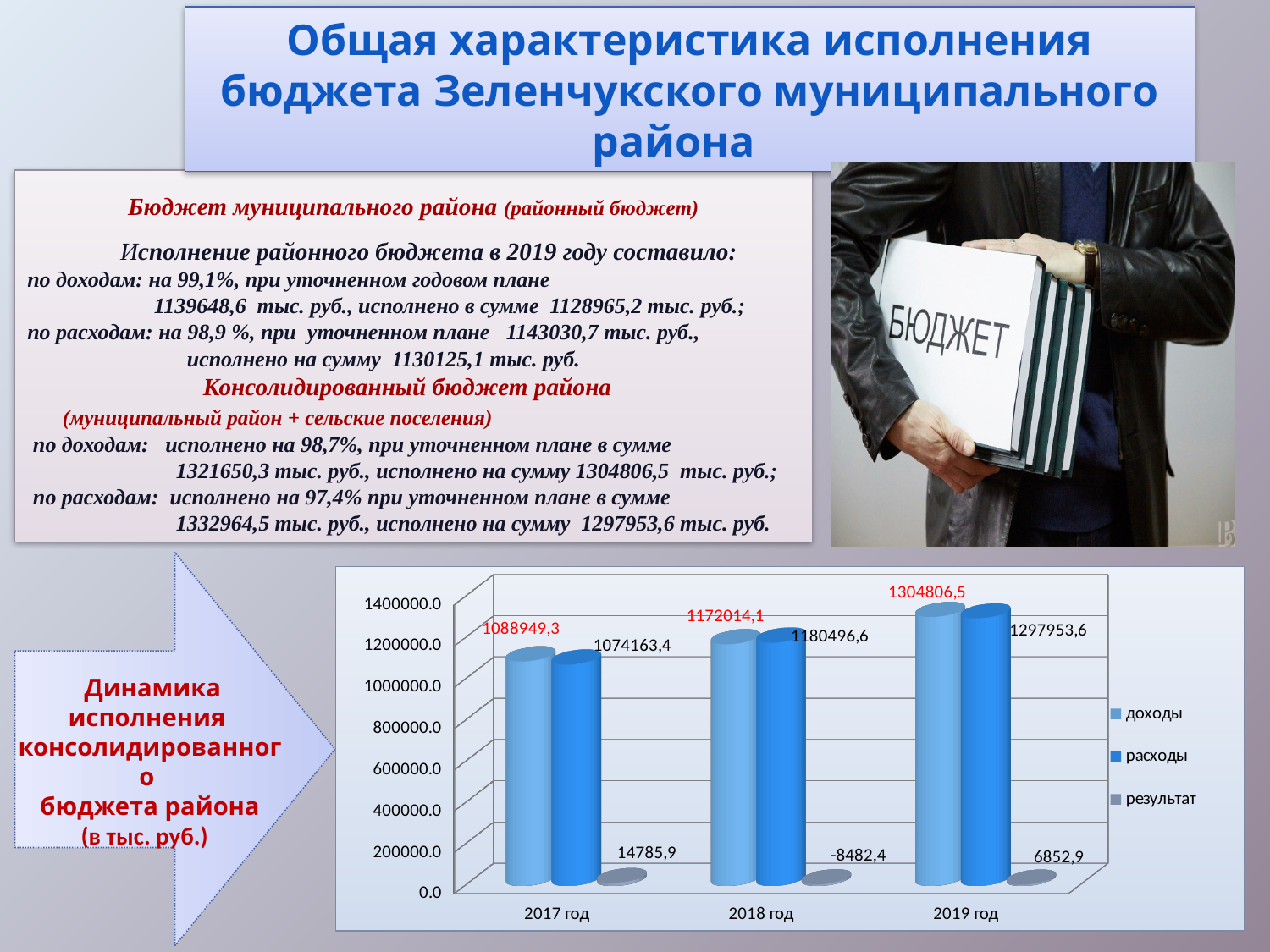
In which year is доходы the highest? 2019 год In which year is расходы the lowest? 2017 год Do the values of доходы rise or fall from 2017 год to 2019 год? rise Which series is shown in the darker blue colour in the chart legend? расходы How many year categories are shown on the x axis of the chart? 3 What is the value of расходы for 2017 год? 1074163,4 What is the value of доходы for 2019 год? 1304806,5 What is the difference between доходы and расходы in 2019 год? 6852,9 What is the value of результат for 2018 год? -8482,4 What type of chart is shown on the slide? bar chart Which is larger in 2018 год: доходы or расходы? расходы How many series does the chart legend list? 3